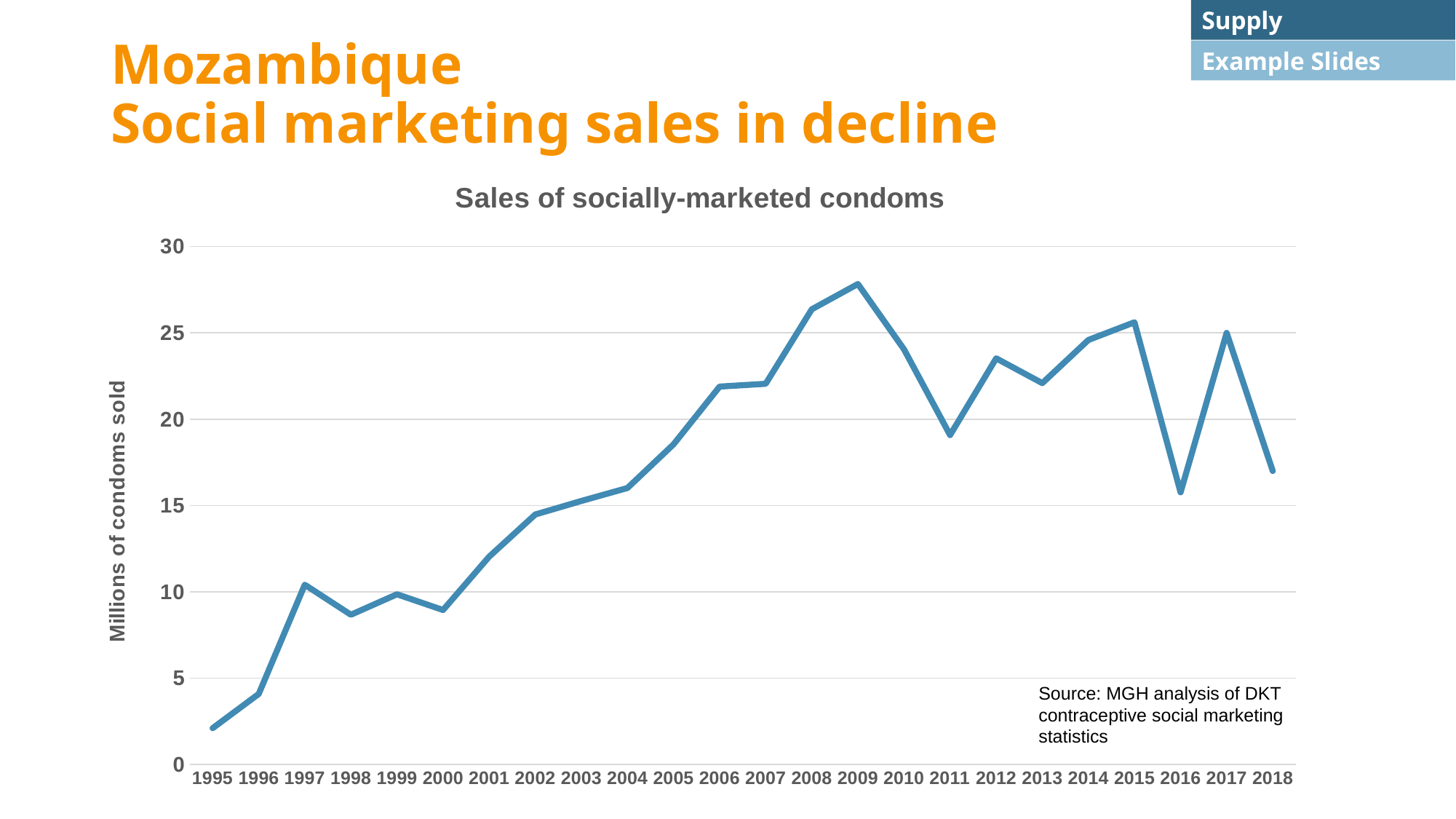
How many years are plotted along the x axis of the chart? 24 What is the label on the vertical axis of the chart? Millions of condoms sold What kind of chart is shown on the slide? line chart In which year were sales of socially-marketed condoms highest? 2009 Do sales generally rise or fall between 1995 and 2009? rise Is the value for 2008 greater or less than 25? greater Is the value for 2016 greater or less than 20? less In which year were sales of socially-marketed condoms lowest? 1995 Is the value for 2006 greater or less than 20? greater Which year has the larger value, 2016 or 2017? 2017 What is the title of the chart? Sales of socially-marketed condoms